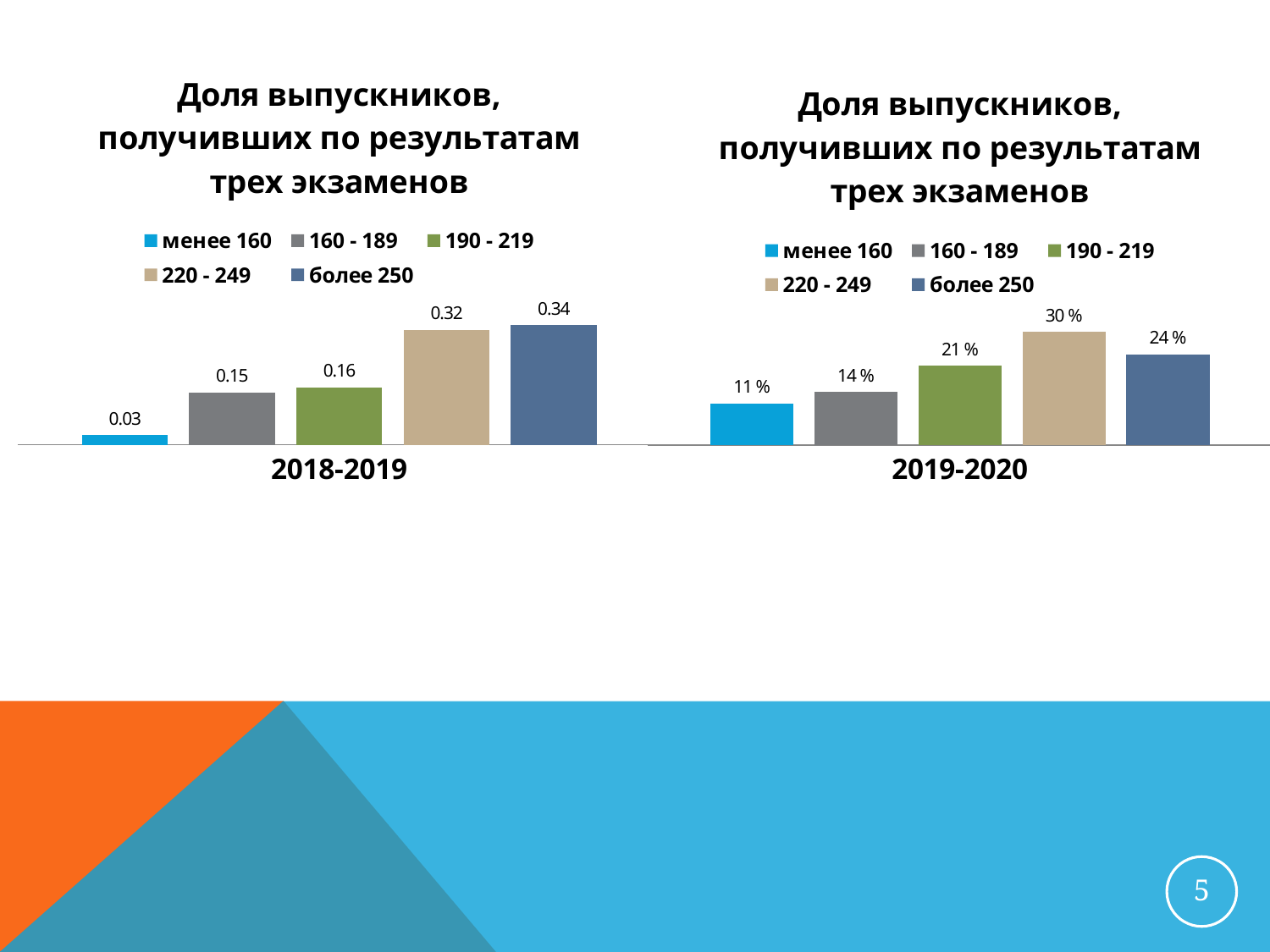
How many series does the legend of the left chart (2018-2019) list? 5 In the left chart (2018-2019), what is the value for the '220 - 249' series? 0.32 In the left chart (2018-2019), what is the value for the 'менее 160' series? 0.03 In the right chart (2019-2020), what is the difference between the values for '220 - 249' and '160 - 189'? 16 % In the left chart (2018-2019), what is the difference between the values for 'более 250' and 'менее 160'? 0.31 In the right chart (2019-2020), which is larger: the value for '220 - 249' or the value for 'более 250'? 220 - 249 What kind of chart is the right chart (2019-2020)? Bar chart In the right chart (2019-2020), what is the value for the 'более 250' series? 24 % In the left chart (2018-2019), which series has the highest value? более 250 In the right chart (2019-2020), which series has the lowest value? менее 160 In the right chart (2019-2020), what is the value for the '190 - 219' series? 21 % In the right chart (2019-2020), which series has the highest value? 220 - 249